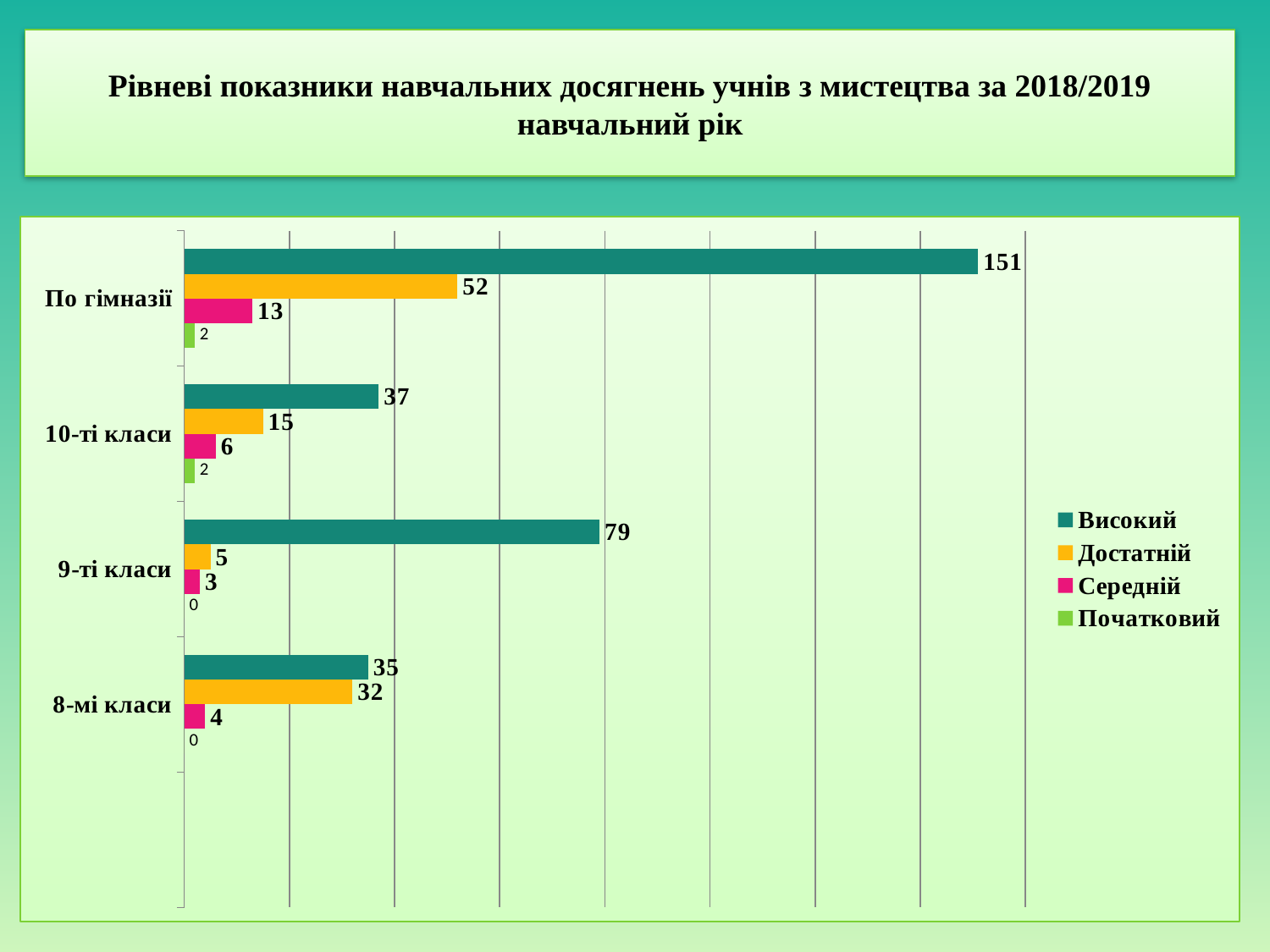
What is the value for Початковий for 9-ті класи? 0 What is the value for Високий for По гімназії? 151 Which category has the highest value for Високий? По гімназії Which series is shown in pink? Середній Which category has the lowest value for Достатній? 9-ті класи How many series does the legend list? 4 What is the value for Середній for 10-ті класи? 6 What is the value for Достатній for 8-мі класи? 32 What kind of chart is shown on the slide? Bar chart What is the difference between the Високий values for 9-ті класи and 10-ті класи? 42 How many categories are shown on the chart? 4 Which is larger for 8-мі класи: Високий or Достатній? Високий